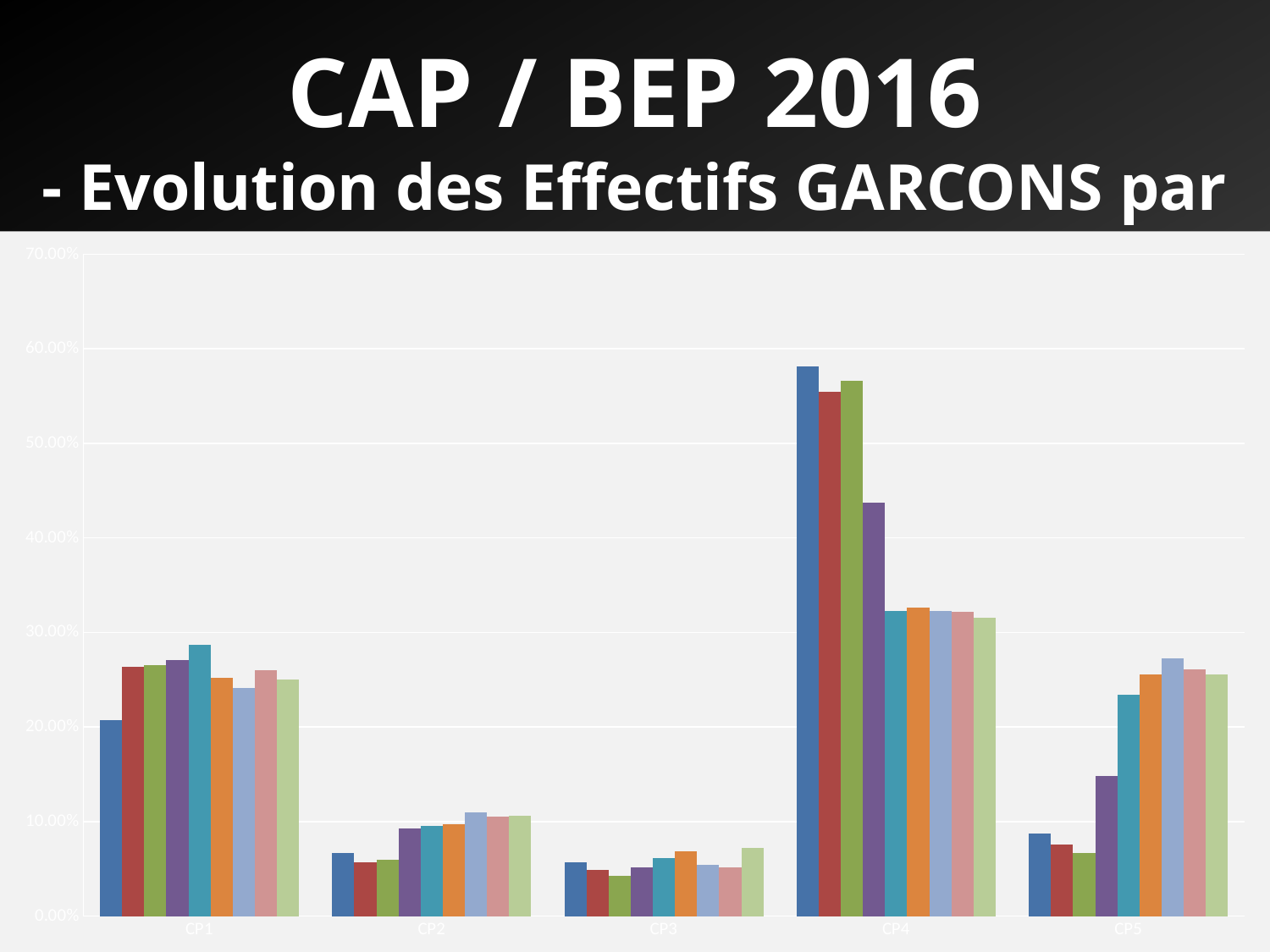
What is the main title at the top of the slide? CAP / BEP 2016 Is the value of the first (blue) bar for CP5 greater or less than 10.00%? less Which category has the tallest bar in the chart? CP4 How many bars are plotted for each category in the chart? 9 What kind of chart is shown on the slide? bar chart Is the value of the first (blue) bar for CP4 greater or less than 50.00%? greater Is the value of the first (blue) bar for CP1 greater or less than 30.00%? less Which is larger, the first (blue) bar for CP1 or the first (blue) bar for CP2? CP1 What is the highest value shown on the y axis of the chart? 70.00% Which is larger, the first (blue) bar for CP4 or the first (blue) bar for CP1? CP4 How many categories are shown on the x axis of the chart? 5